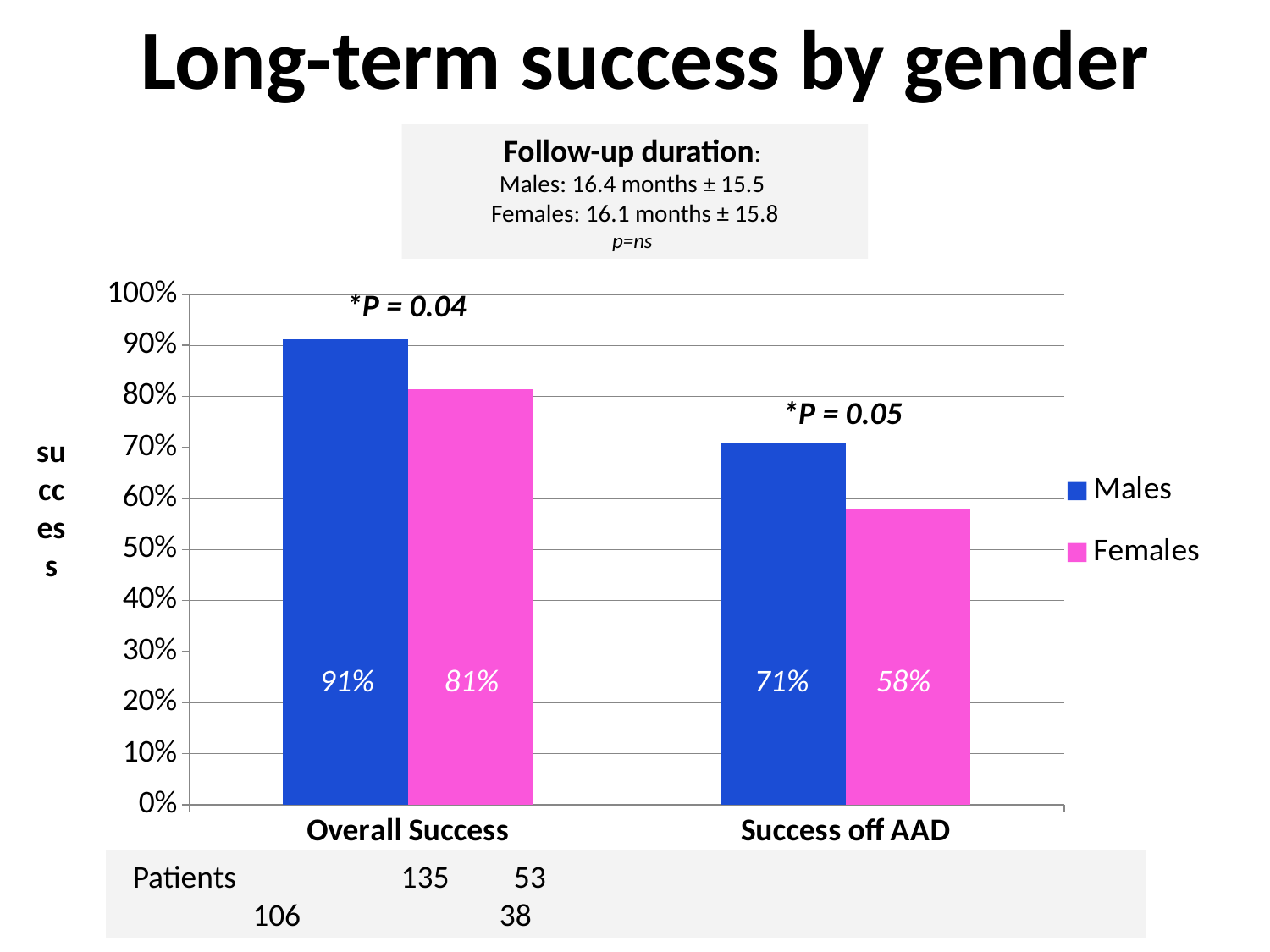
What is the Overall Success value for Females? 81% How many series does the legend list? 2 Which bar has the lowest value in the chart? Females, Success off AAD Which series has the higher value for Success off AAD? Males What is the Success off AAD value for Males? 71% What is the difference between the Males and Females values for Success off AAD? 13% What is the Overall Success value for Males? 91% What is the Success off AAD value for Females? 58% What is the title of the slide? Long-term success by gender How many categories are shown on the x axis? 2 What is the difference between the Males and Females values for Overall Success? 10% What kind of chart is shown on the slide? Bar chart